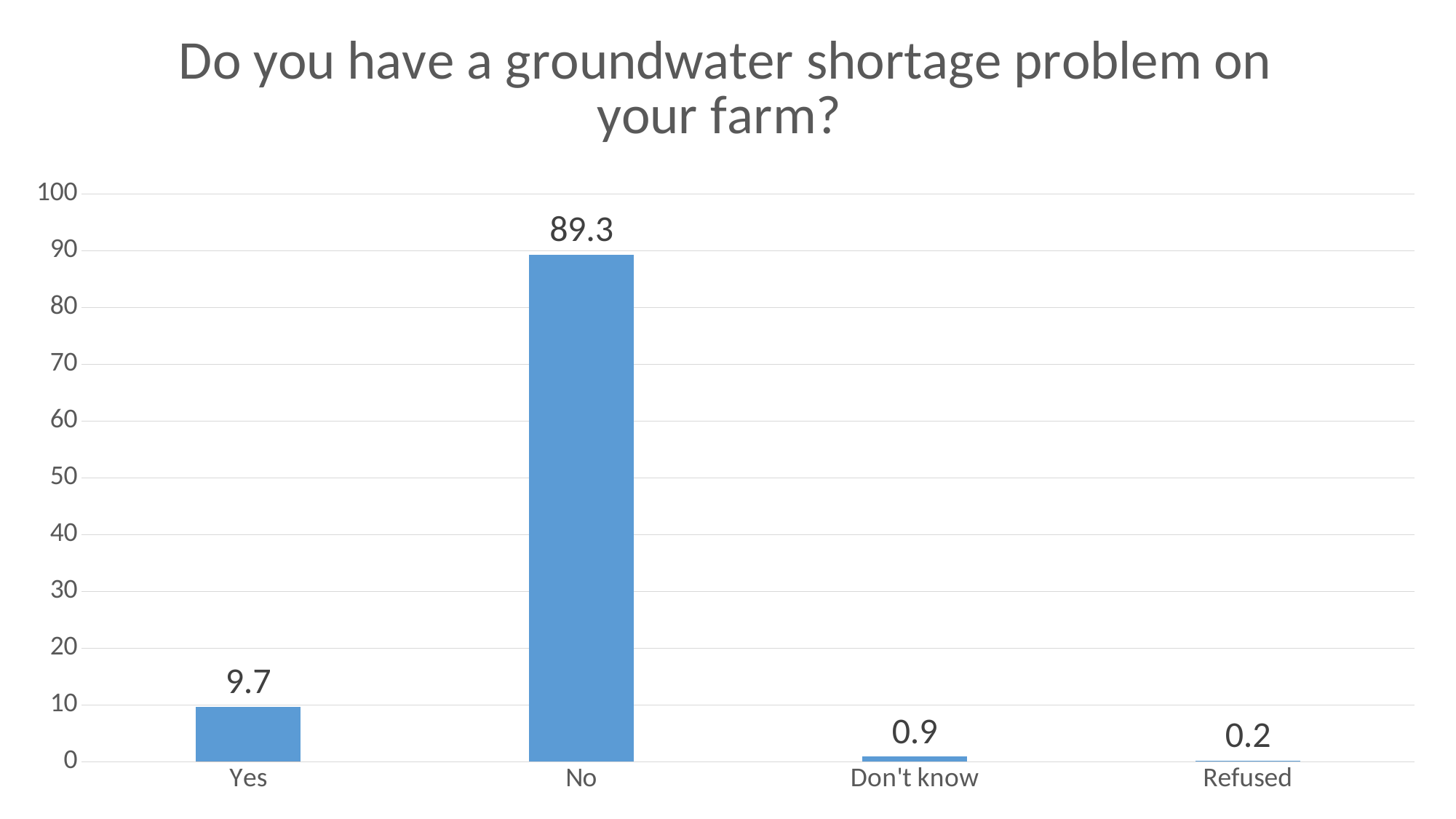
What is the value for "Yes"? 9.7 Is the value for "No" greater or less than 80? greater What is the value for "Refused"? 0.2 Which category has the highest value? No What is the difference between the values for "No" and "Yes"? 79.6 How many categories are shown on the x axis? 4 Which is larger, the value for "Yes" or the value for "Don't know"? Yes What kind of chart is shown on the slide? Bar chart What is the value for "No"? 89.3 Which category has the lowest value? Refused What is the title of the chart? Do you have a groundwater shortage problem on your farm? What is the value for "Don't know"? 0.9